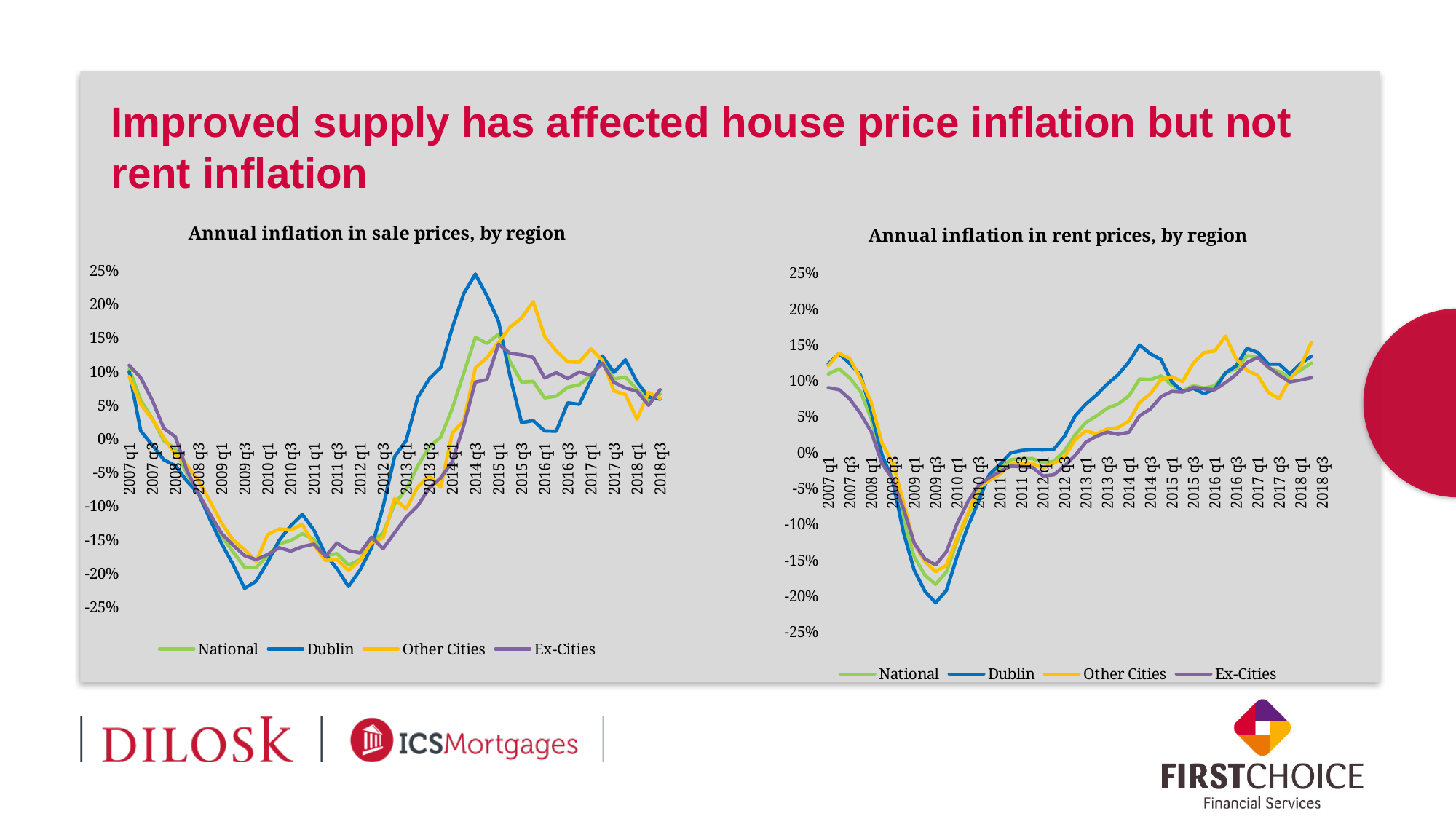
In the 'Annual inflation in sale prices, by region' chart, is the Dublin value at 2009 q3 greater or less than -20%? less In the 'Annual inflation in rent prices, by region' chart, which series falls to the lowest point around 2009 q3? Dublin In the 'Annual inflation in rent prices, by region' chart, is the Dublin value at 2009 q3 greater or less than -15%? less In the 'Annual inflation in sale prices, by region' chart, does the Dublin line rise or fall between 2014 q3 and 2015 q3? fall In the 'Annual inflation in sale prices, by region' chart, is the Dublin value at 2014 q3 greater or less than 20%? greater In the 'Annual inflation in sale prices, by region' chart, which series reaches the highest peak? Dublin What kind of chart is the 'Annual inflation in sale prices, by region' chart? line chart In the 'Annual inflation in rent prices, by region' chart, which is larger at 2007 q1: Dublin or Ex-Cities? Dublin How many series does the legend of the 'Annual inflation in rent prices, by region' chart list? 4 In the 'Annual inflation in sale prices, by region' chart, which is larger at 2014 q3: Dublin or National? Dublin Which series is drawn in purple in the 'Annual inflation in rent prices, by region' chart? Ex-Cities